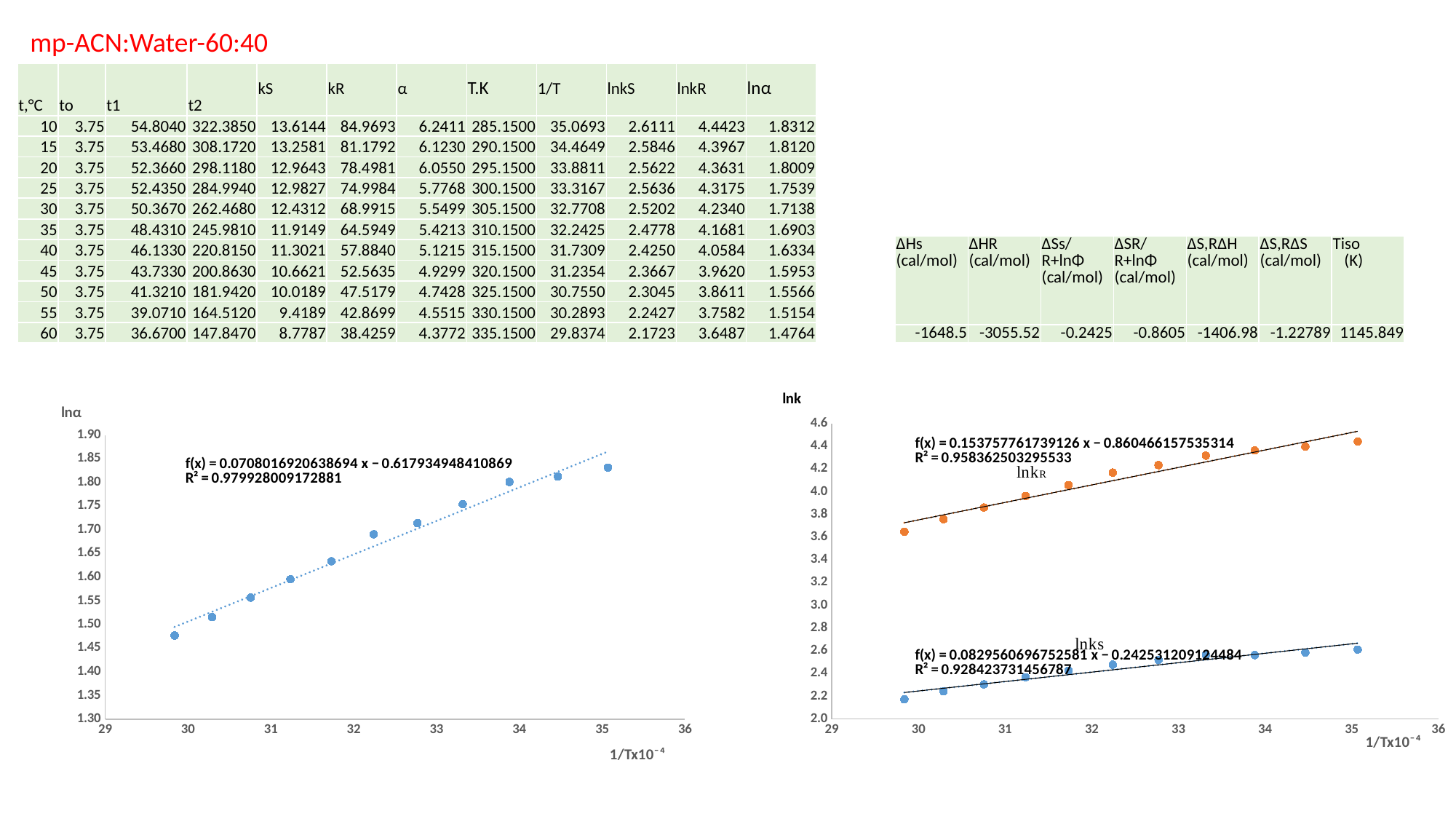
In the left chart (lnα), is the value of the rightmost point (near 1/Tx10⁻⁴ = 35) greater or less than 1.80? greater In the right chart (lnk), how many series are plotted? 2 What kind of chart is the left chart titled lnα? scatter chart In the left chart (lnα), is the value of the leftmost point (near 1/Tx10⁻⁴ = 30) greater or less than 1.50? less In the right chart (lnk), which series has the higher values, lnkR or lnkS? lnkR In the left chart (lnα), what R² value is shown for the trendline? 0.979928009172881 In the right chart (lnk), is the lnkR value at the leftmost point (near 1/Tx10⁻⁴ = 30) greater or less than 3.8? less In the left chart (lnα), how many data points are plotted? 11 In the right chart (lnk), do the lnkS values rise or fall as 1/Tx10⁻⁴ increases? rise In the left chart (lnα), do the values rise or fall as 1/Tx10⁻⁴ increases? rise In the right chart (lnk), what R² value is shown for the lnkR trendline? 0.958362503295533